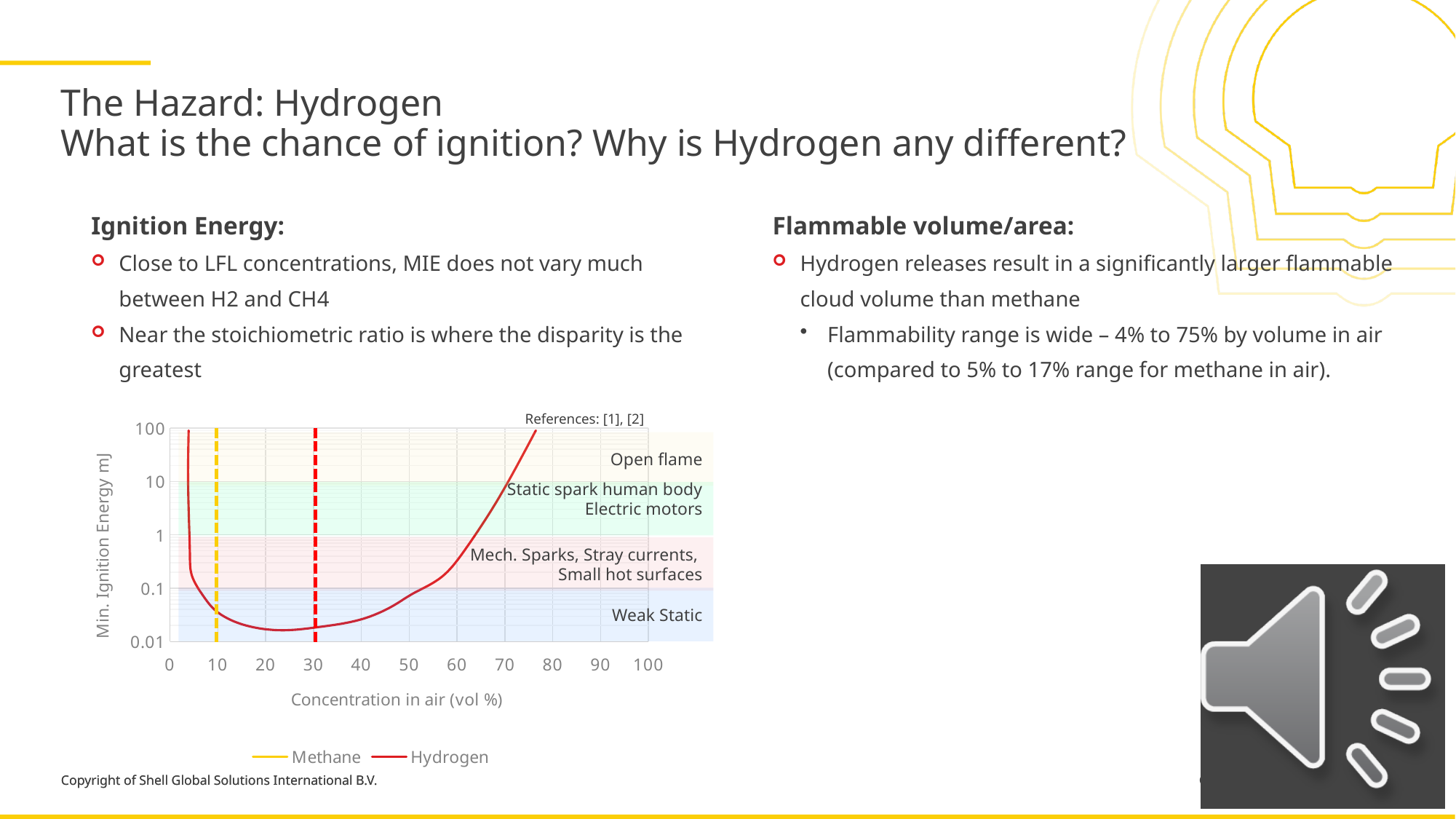
Is the minimum ignition energy of the Hydrogen curve at 60 vol % concentration greater or less than 1 mJ? less Is the minimum ignition energy of the Hydrogen curve at 60 vol % concentration greater or less than 0.1 mJ? greater How many series does the chart legend list? 2 What kind of chart is shown on the slide? line chart Which is larger on the Hydrogen curve: the minimum ignition energy at 20 vol % or at 60 vol %? 60 vol % Does the Hydrogen curve rise or fall as concentration increases from 30 vol % to 70 vol %? rise What is the label of the chart's y axis? Min. Ignition Energy mJ Does the Hydrogen curve rise or fall as concentration increases from 5 vol % to 20 vol %? fall What is the highest value shown on the chart's y axis? 100 Which two series are listed in the chart legend? Methane and Hydrogen Is the minimum ignition energy of the Hydrogen curve at 30 vol % concentration greater or less than 0.1 mJ? less